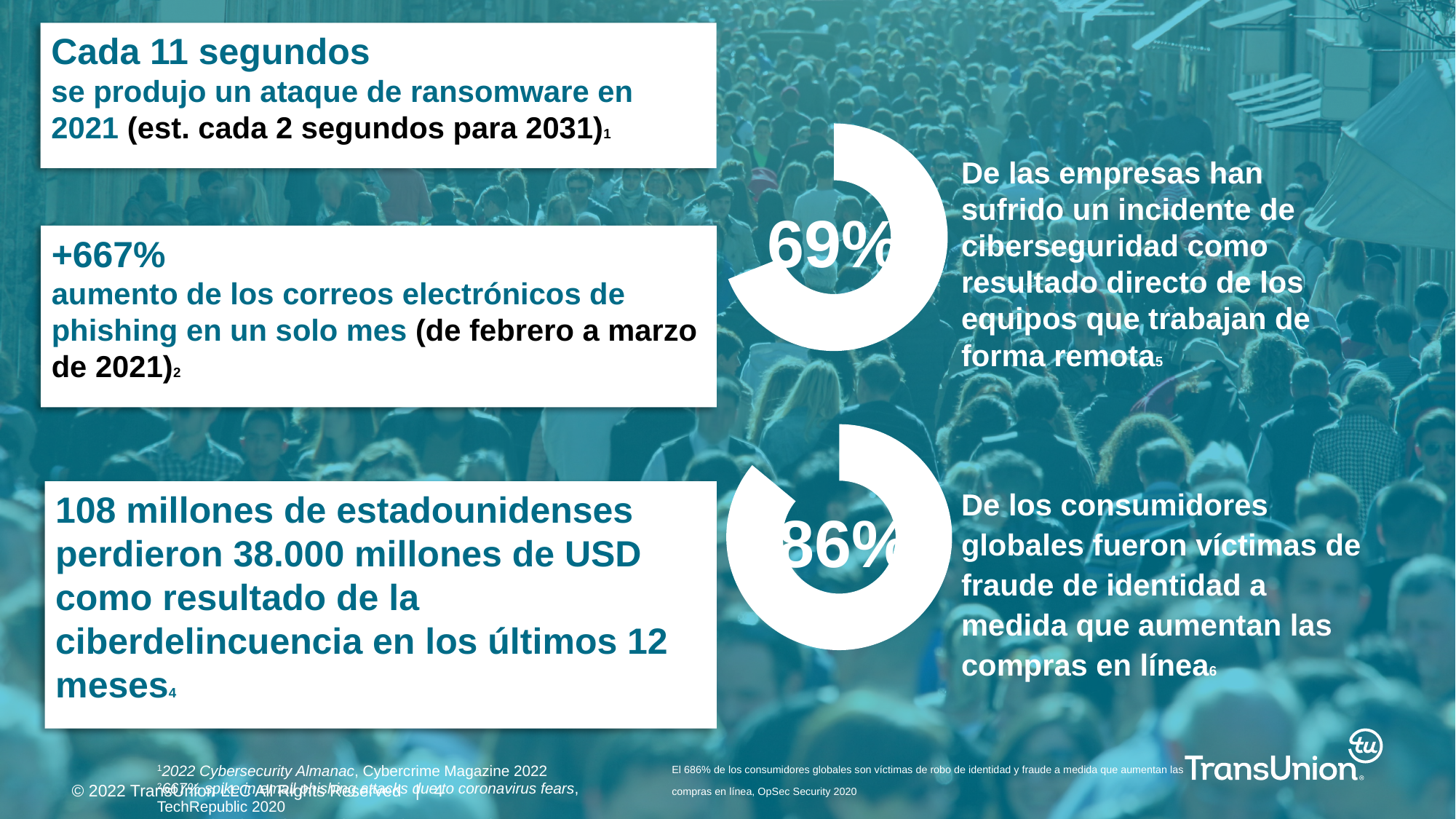
What is the difference between the value in the lower donut chart (86%) and the value in the upper donut chart (69%)? 17 percentage points What percentage is displayed in the upper donut chart on the right side of the slide? 69% According to the text next to the upper donut chart, what does the 69% figure represent? Companies that have suffered a cybersecurity incident as a direct result of teams working remotely Is the value shown in the lower donut chart greater or less than 90%? less What share of the upper donut chart is filled in, according to its label? 69% According to the text next to the lower donut chart, what does the 86% figure represent? Global consumers who were victims of identity fraud as online shopping increases Is the value shown in the upper donut chart greater or less than 50%? greater What percentage is displayed in the lower donut chart on the right side of the slide? 86% How many donut charts are shown on the slide? 2 What kind of chart is used to show the 69% and 86% figures? Donut (pie) chart Which donut chart shows the larger value, the upper one (69%) or the lower one (86%)? The lower one (86%)